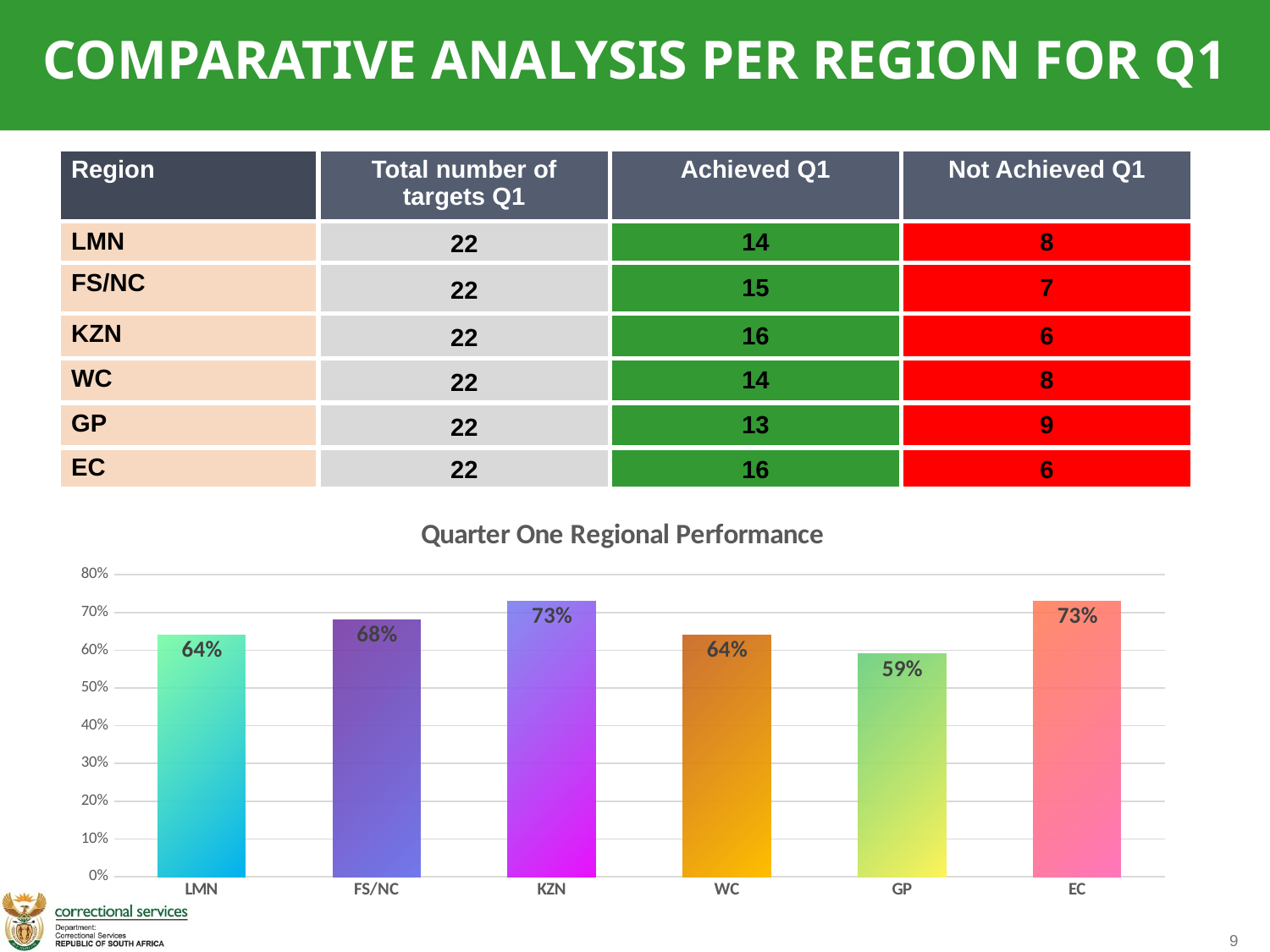
What is the title of the chart on the slide? Quarter One Regional Performance Is the value for GP in the Quarter One Regional Performance chart greater or less than 60%? less Which is larger in the Quarter One Regional Performance chart, the value for FS/NC or the value for WC? FS/NC What is the value for KZN in the Quarter One Regional Performance chart? 73% Which region has the lowest value in the Quarter One Regional Performance chart? GP What is the difference between the values for FS/NC and LMN in the Quarter One Regional Performance chart? 4% What is the value for FS/NC in the Quarter One Regional Performance chart? 68% What is the difference between the values for KZN and GP in the Quarter One Regional Performance chart? 14% Is the value for EC in the Quarter One Regional Performance chart greater or less than 70%? greater How many regions are shown in the Quarter One Regional Performance chart? 6 What kind of chart is the Quarter One Regional Performance chart? bar chart What is the value for GP in the Quarter One Regional Performance chart? 59%